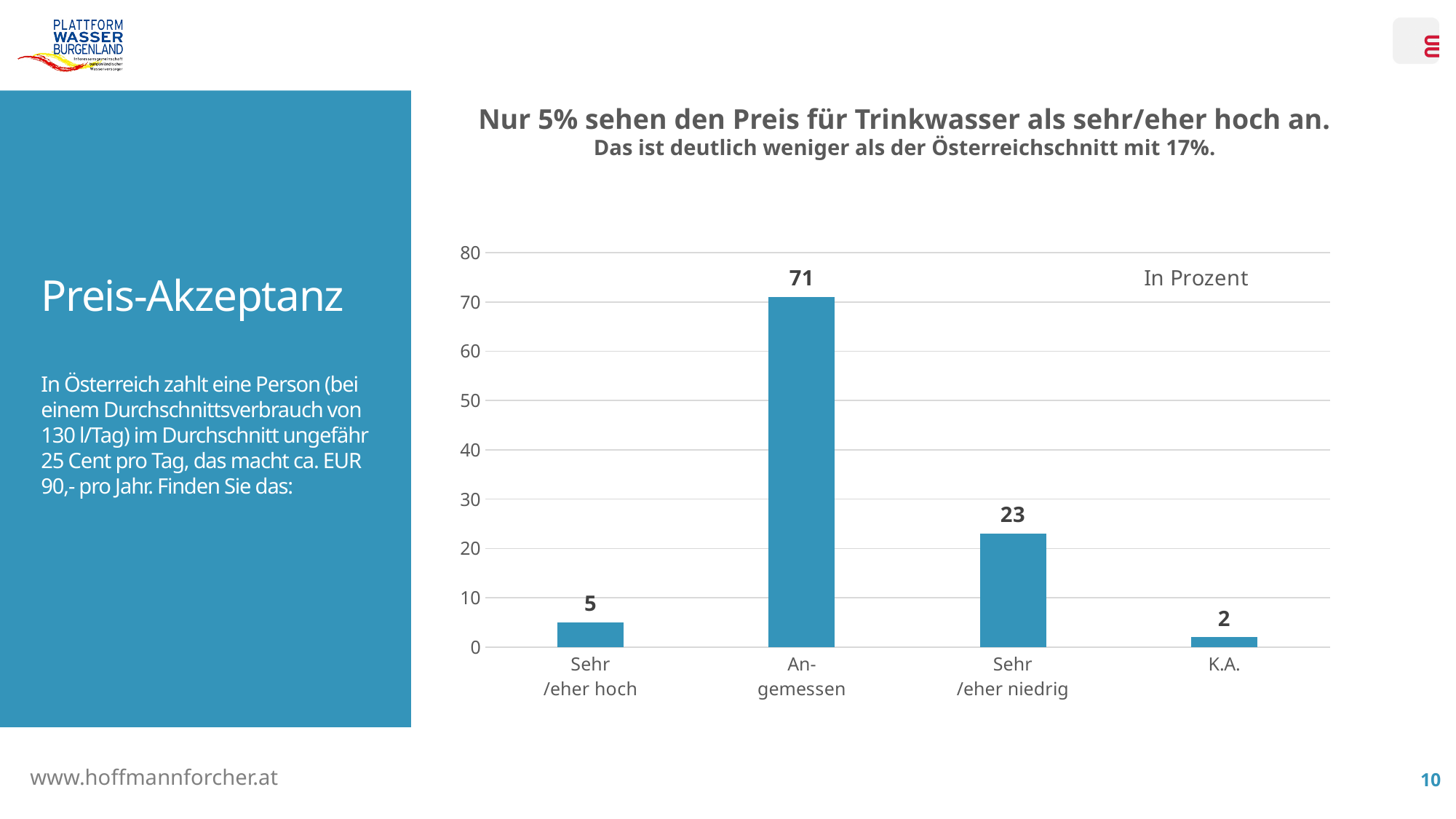
What is the value for "Angemessen"? 71 What unit label is shown in the top right of the chart area? In Prozent What is the value for "K.A."? 2 What is the value for "Sehr/eher hoch"? 5 Which category has the highest value? Angemessen Which category has the lowest value? K.A. What is the value for "Sehr/eher niedrig"? 23 Which is larger, the value for "Sehr/eher hoch" or the value for "Sehr/eher niedrig"? Sehr/eher niedrig How many categories are shown on the x axis? 4 What is the difference between the values for "Angemessen" and "Sehr/eher niedrig"? 48 Is the value for "Angemessen" greater or less than 60? greater What kind of chart is shown on the slide? bar chart